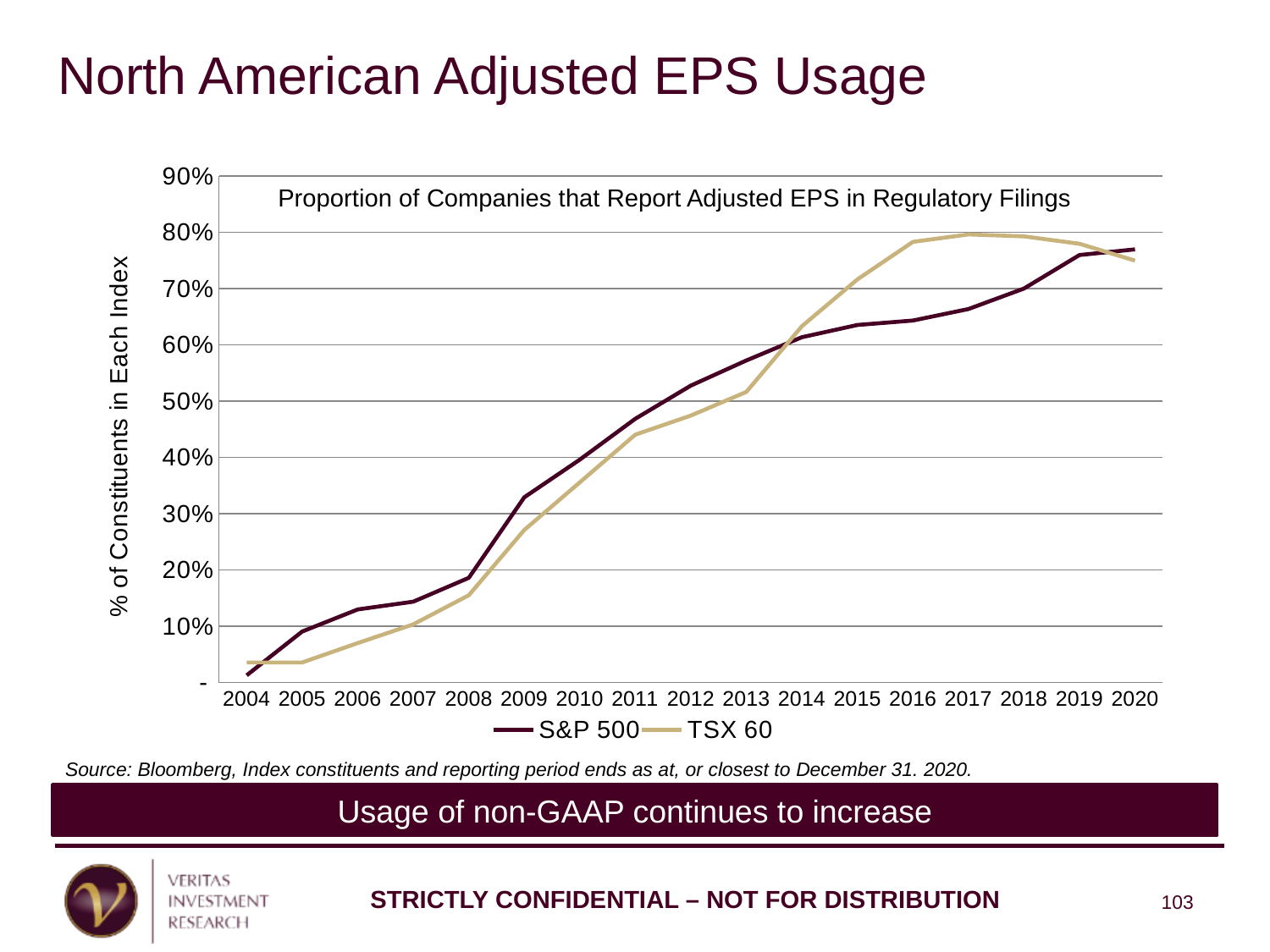
Is the value for the S&P 500 in 2014 greater or less than 50%? greater In 2016, which series has the higher value, S&P 500 or TSX 60? TSX 60 What kind of chart is shown on the slide? Line chart What is the title shown inside the chart area? Proportion of Companies that Report Adjusted EPS in Regulatory Filings Is the value for the TSX 60 in 2020 greater or less than 70%? greater Is the value for the S&P 500 in 2006 greater or less than 10%? greater In which year is the S&P 500 value lowest? 2004 Does the S&P 500 line generally rise or fall from 2004 to 2020? Rise How many years are shown along the x axis? 17 How many series does the legend list? 2 In 2010, which series has the higher value, S&P 500 or TSX 60? S&P 500